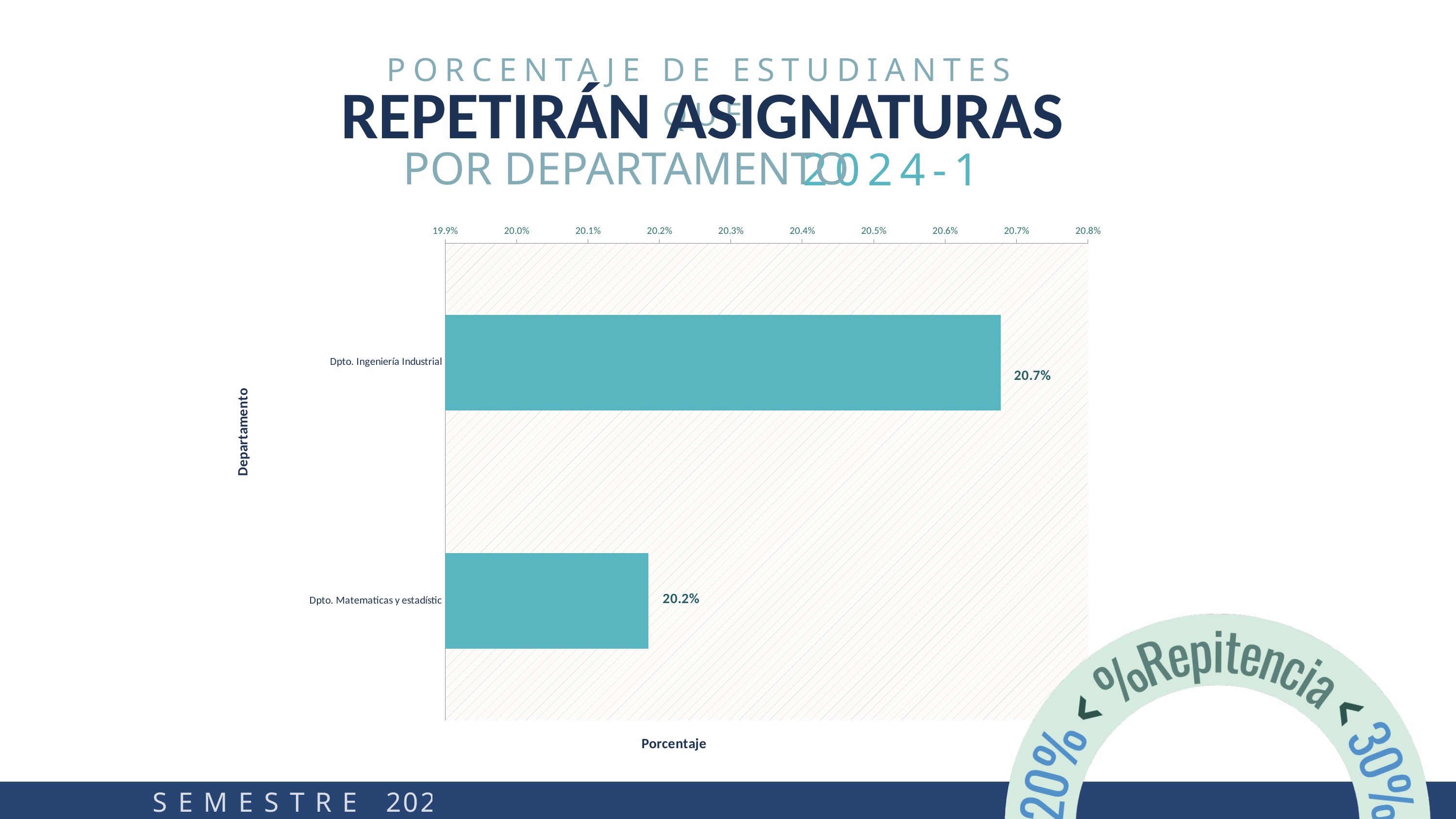
Which department has the lowest percentage? Dpto. Matematicas y estadístic What is the title of the vertical axis of the chart? Departamento What kind of chart is shown on the slide? bar chart What is the difference between the values for Dpto. Ingeniería Industrial and Dpto. Matematicas y estadístic? 0.5% Is the value for Dpto. Matematicas y estadístic greater or less than 20.5%? less How many departments are shown in the chart? 2 Which is larger, the value for Dpto. Ingeniería Industrial or the value for Dpto. Matematicas y estadístic? Dpto. Ingeniería Industrial What is the value for Dpto. Ingeniería Industrial? 20.7% What is the value for Dpto. Matematicas y estadístic? 20.2% Which department has the highest percentage? Dpto. Ingeniería Industrial What is the title of the horizontal axis of the chart? Porcentaje Is the value for Dpto. Ingeniería Industrial greater or less than 20.5%? greater